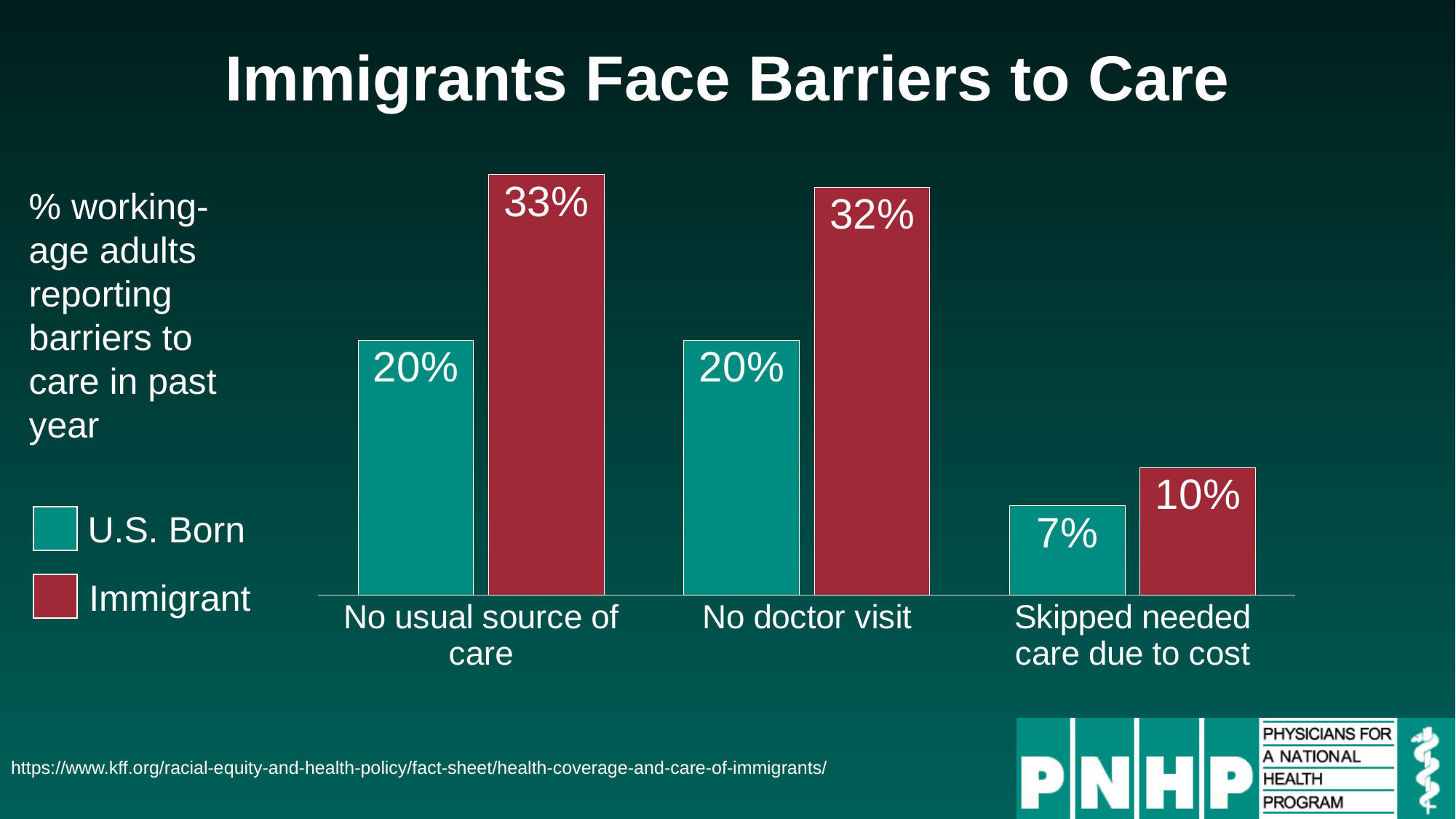
What type of chart is shown on the slide? Bar chart What percentage of U.S. born adults reported skipping needed care due to cost? 7% What is the difference between the immigrant and U.S. born values for no usual source of care? 13 percentage points Which barrier category has the highest value for immigrants? No usual source of care Which group has the larger value for skipped needed care due to cost, U.S. born or immigrant? Immigrant How many barrier categories are shown on the x axis? 3 How many series does the legend list? 2 Which barrier category has the lowest value for U.S. born adults? Skipped needed care due to cost What is the difference between the immigrant and U.S. born values for no doctor visit? 12 percentage points What percentage of immigrants reported skipping needed care due to cost? 10% What percentage of immigrants reported having no usual source of care? 33% What percentage of U.S. born adults reported no doctor visit? 20%